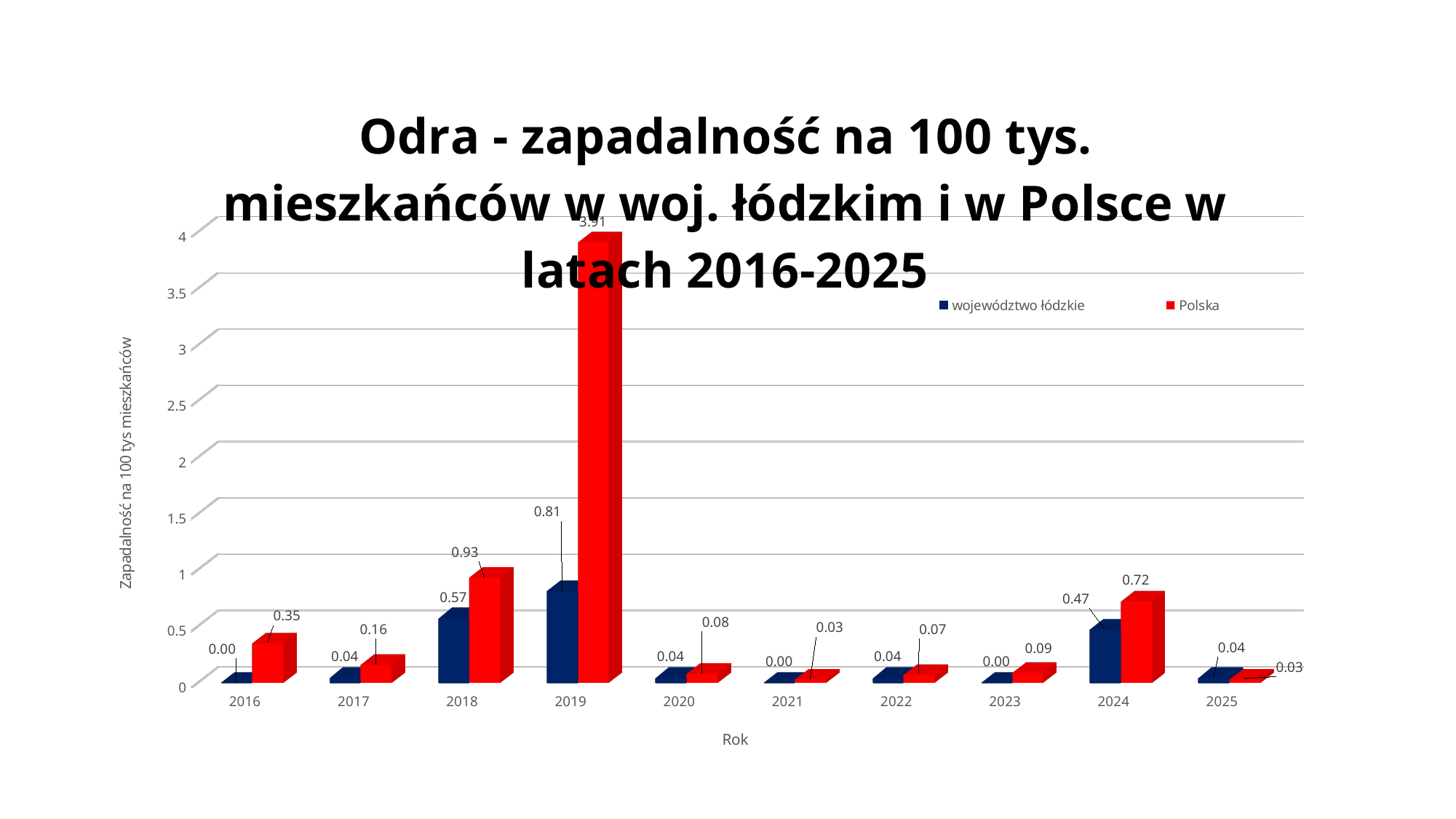
What is the value for Polska in 2024? 0.72 What is the label of the y axis? Zapadalność na 100 tys mieszkańców How many years are shown on the x axis? 10 Which is larger in 2025: the value for województwo łódzkie or for Polska? województwo łódzkie What kind of chart is shown on the slide? bar chart What is the value for Polska in 2019? 3.91 What is the value for województwo łódzkie in 2024? 0.47 In which year is the value for województwo łódzkie highest? 2019 What is the difference between the Polska and województwo łódzkie values in 2018? 0.36 How many series does the legend list? 2 What is the value for województwo łódzkie in 2018? 0.57 In which year is the value for Polska highest? 2019